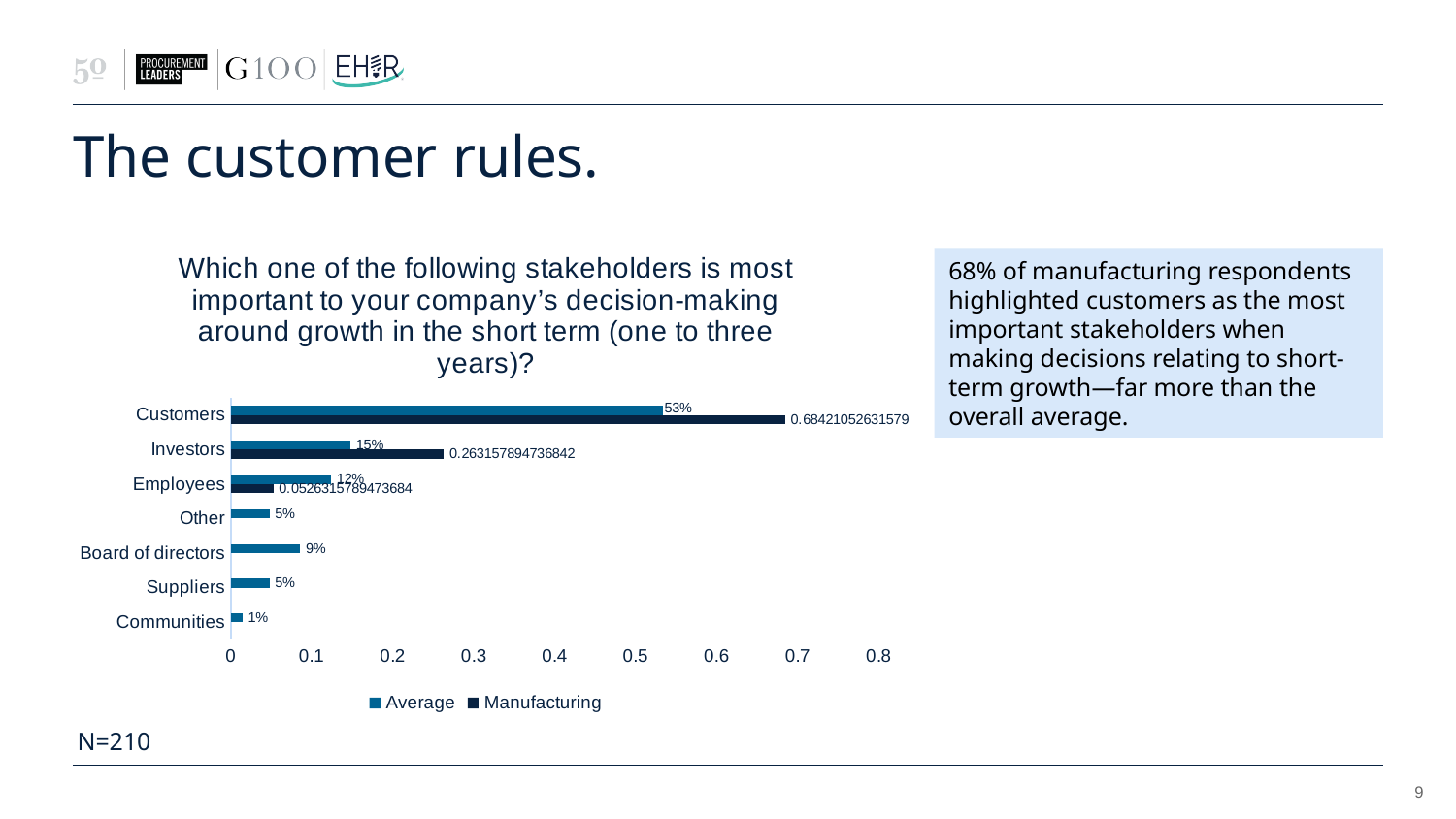
How many stakeholder categories are shown on the chart? 7 What is the Average value for Board of directors? 9% Which category has the lowest Average value? Communities What is the difference between the Average values for Investors and Employees? 3% How many series does the legend list? 2 Which is larger for Investors: the Average value or the Manufacturing value? Manufacturing Is the Manufacturing value for Customers greater or less than 0.6? greater What kind of chart is shown on the slide? Bar chart What is the Manufacturing value for Customers? 0.68421052631579 Which category has the highest Average value? Customers What is the Manufacturing value for Investors? 0.263157894736842 What is the Average value for Customers? 53%